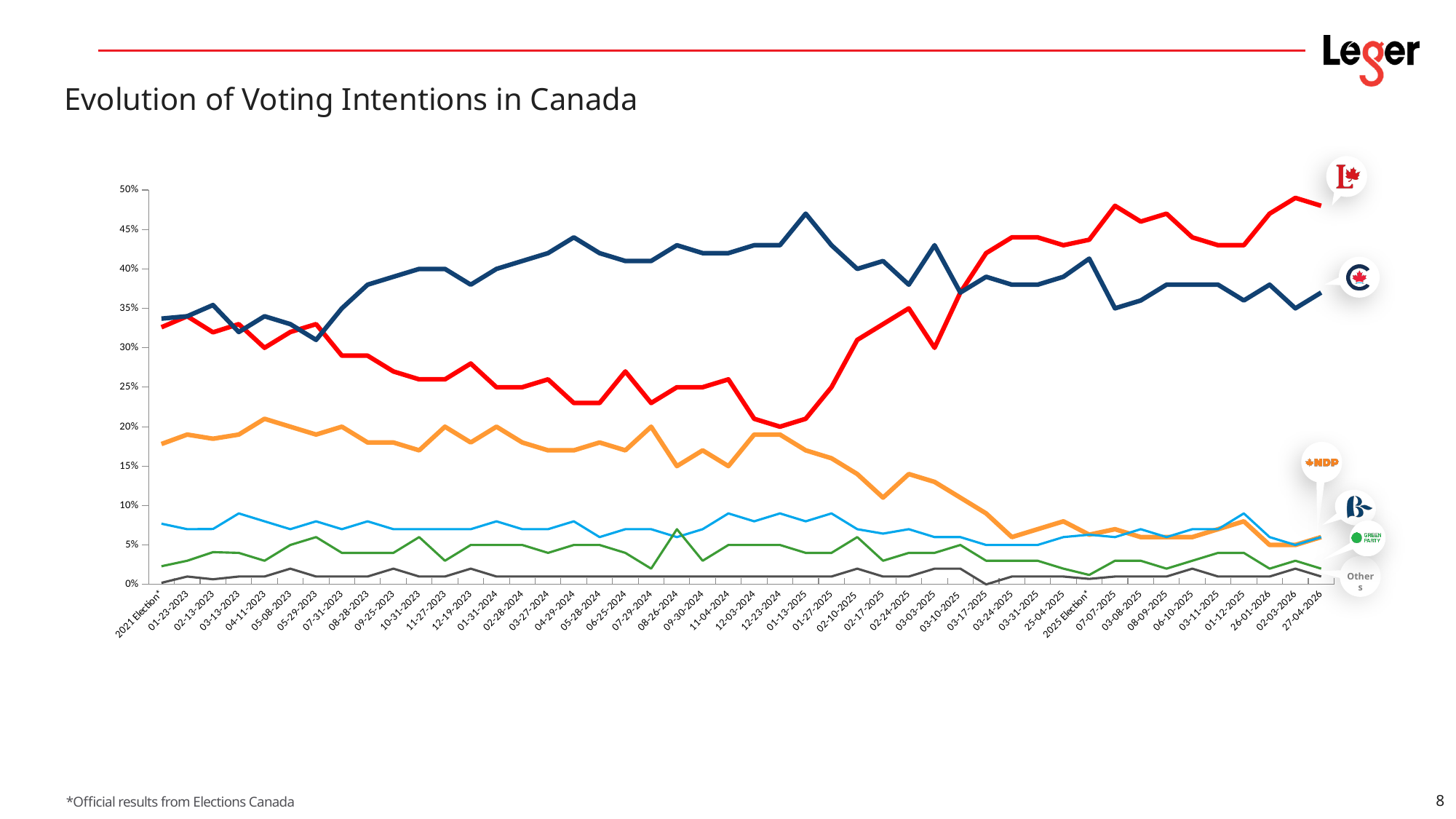
What is the title of the chart? Evolution of Voting Intentions in Canada How many party series are plotted on the chart? 6 Does the red (Liberal) line rise or fall between 01-13-2025 and 03-24-2025? Rise Does the orange (NDP) line rise or fall between 12-23-2024 and 03-24-2025? Fall At 27-04-2026, which line is higher: the red (Liberal) line or the dark blue (Conservative) line? Red (Liberal) At 01-13-2025, which line is higher: the red (Liberal) line or the dark blue (Conservative) line? Dark blue (Conservative) Is the value of the orange (NDP) line at the 2021 Election greater or less than 15%? greater What kind of chart is shown on the slide? Line chart Is the value of the dark blue (Conservative) line at 01-13-2025 greater or less than 45%? greater Is the value of the red (Liberal) line at 27-04-2026 greater or less than 45%? greater